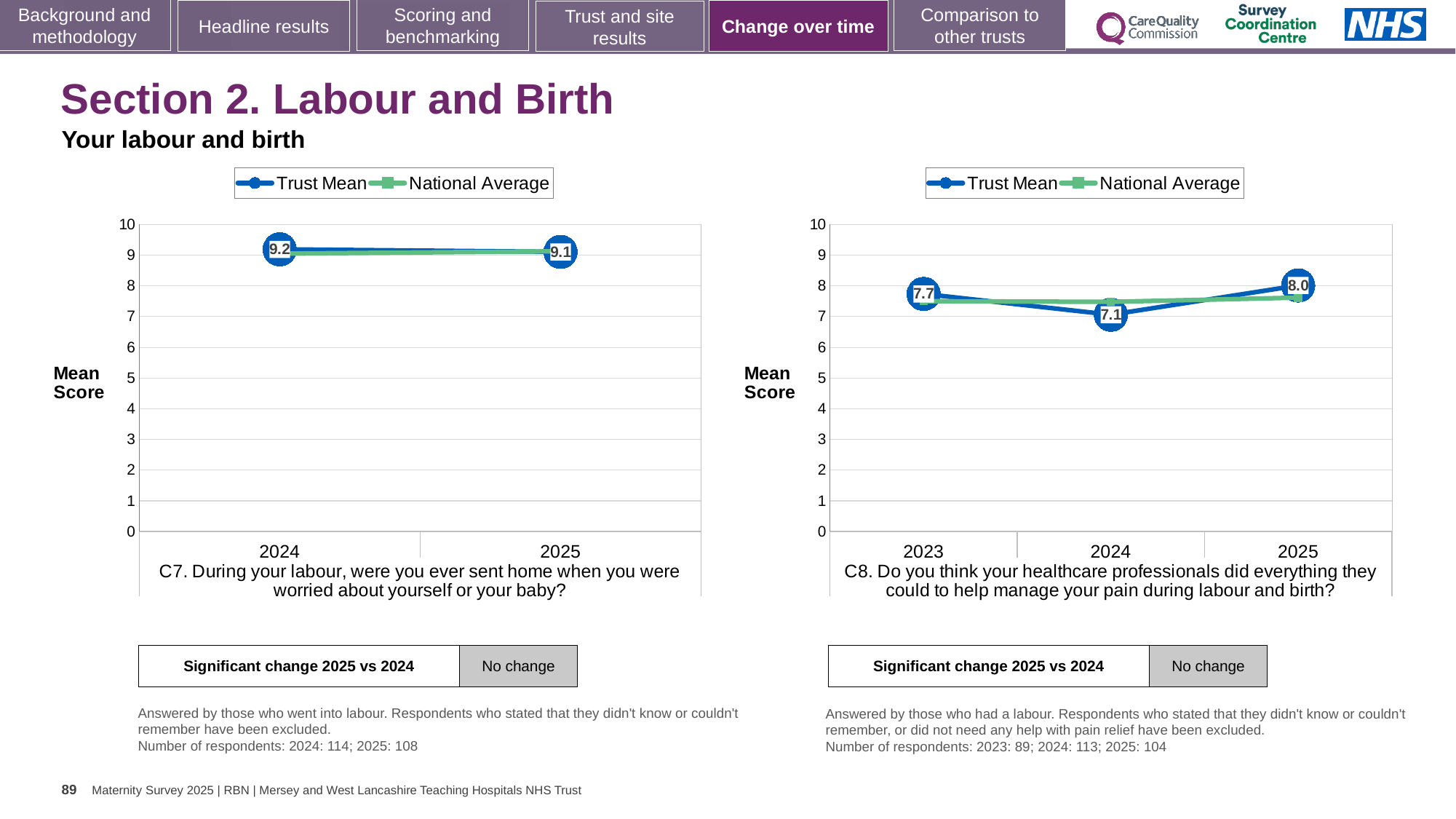
In the C8 chart on the right, what is the difference between the Trust Mean for 2025 and the Trust Mean for 2024? 0.9 What kind of chart is the C8 chart on the right? line chart In the C7 chart on the left, what is the Trust Mean for 2024? 9.2 In the C8 chart on the right, which year has the lowest Trust Mean? 2024 In the C7 chart on the left, what is the Trust Mean for 2025? 9.1 In the C8 chart on the right, which year has the highest Trust Mean? 2025 In the C7 chart on the left, is the National Average for 2024 greater or less than 8? greater How many years are plotted on the x axis of the C8 chart on the right? 3 In the C8 chart on the right, what is the Trust Mean for 2025? 8.0 In the C7 chart on the left, is the Trust Mean for 2024 larger or smaller than the Trust Mean for 2025? larger In the C8 chart on the right, what is the Trust Mean for 2024? 7.1 How many series does the legend of the C7 chart on the left list? 2